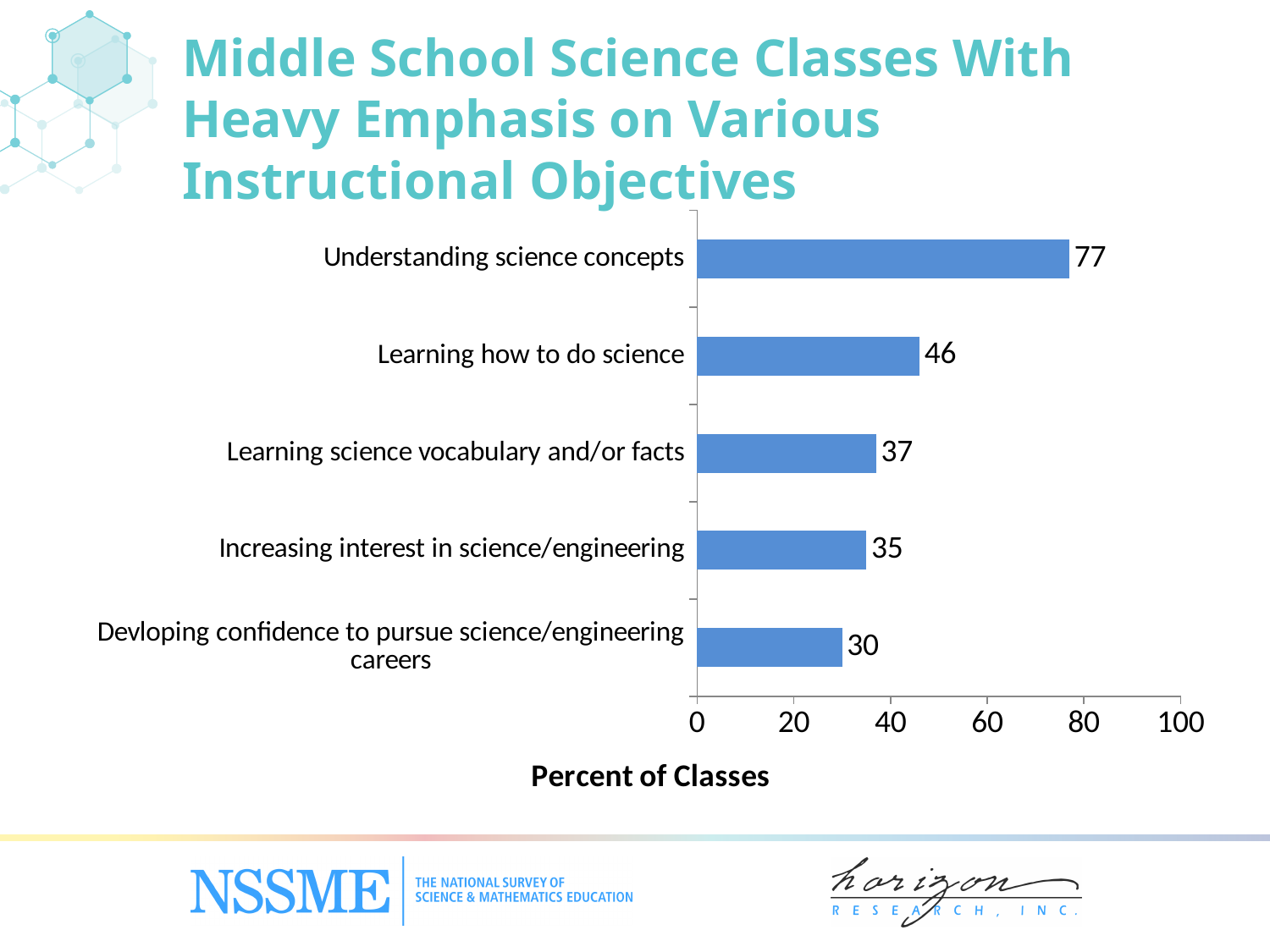
Which is larger: the value for 'Learning science vocabulary and/or facts' or 'Increasing interest in science/engineering'? Learning science vocabulary and/or facts Is the value for 'Increasing interest in science/engineering' greater or less than 40? less What is the value for 'Learning how to do science'? 46 What kind of chart is shown on the slide? Bar chart Which instructional objective has the highest percent of classes? Understanding science concepts What percent of classes place heavy emphasis on understanding science concepts? 77 Which instructional objective has the lowest percent of classes? Devloping confidence to pursue science/engineering careers What is the value for 'Devloping confidence to pursue science/engineering careers'? 30 What is the value for 'Learning science vocabulary and/or facts'? 37 How many instructional objectives are shown in the chart? 5 What is the label of the horizontal axis? Percent of Classes What is the difference between the values for 'Understanding science concepts' and 'Learning how to do science'? 31